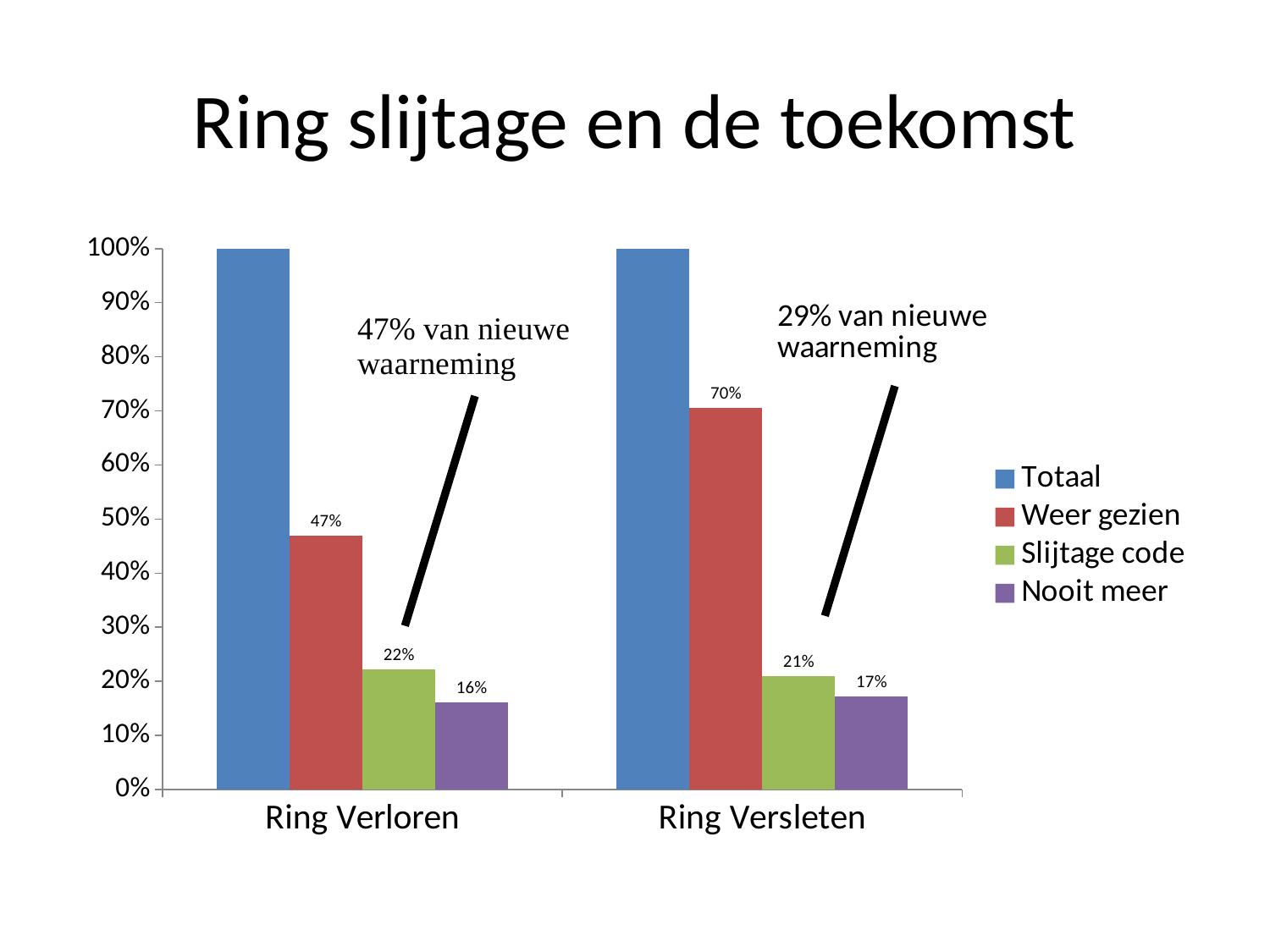
What is the value of Weer gezien for Ring Verloren? 47% What is the title of the slide? Ring slijtage en de toekomst What is the value of Weer gezien for Ring Versleten? 70% What is the value of Slijtage code for Ring Verloren? 22% Which series has the lowest value for Ring Verloren? Nooit meer Which is larger: Nooit meer for Ring Verloren or Nooit meer for Ring Versleten? Ring Versleten What kind of chart is shown on the slide? bar chart Is the value of Totaal for Ring Verloren greater or less than 90%? greater How many categories are shown on the x axis? 2 How many series does the legend list? 4 What is the value of Nooit meer for Ring Versleten? 17% What is the difference between the Weer gezien values for Ring Versleten and Ring Verloren? 23%